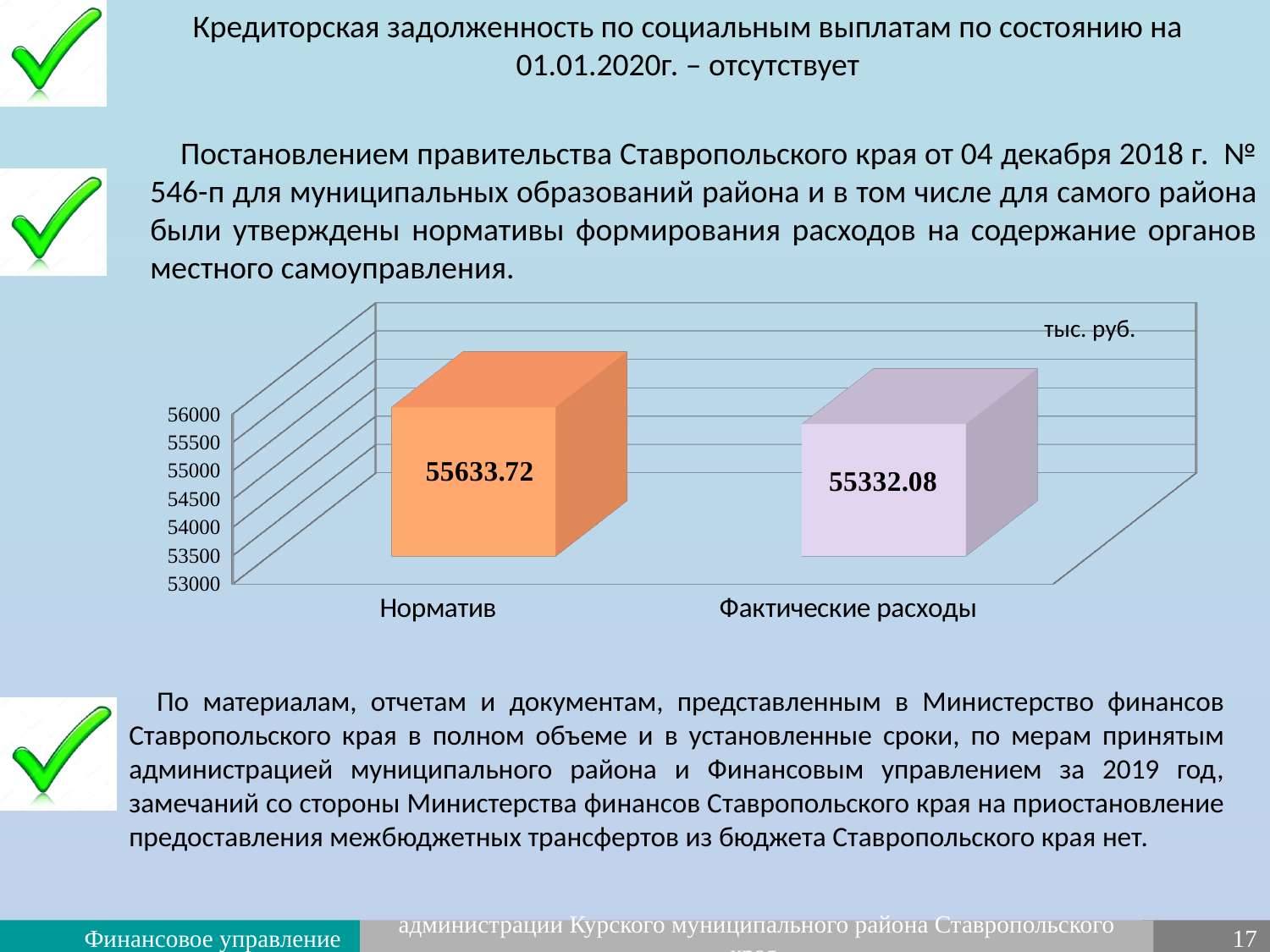
Which category has the highest value? Норматив What unit is indicated on the chart? тыс. руб. What is the difference between the value for Норматив and the value for Фактические расходы? 301.64 Which category has the lowest value? Фактические расходы What is the value for Фактические расходы? 55332.08 What is the lowest value shown on the vertical axis of the chart? 53000 Which is larger, the value for Норматив or the value for Фактические расходы? Норматив Is the value for Норматив greater or less than 55500? greater Is the value for Фактические расходы greater or less than 55500? less What is the value for Норматив? 55633.72 What kind of chart is shown on the slide? bar chart How many categories are shown in the chart? 2